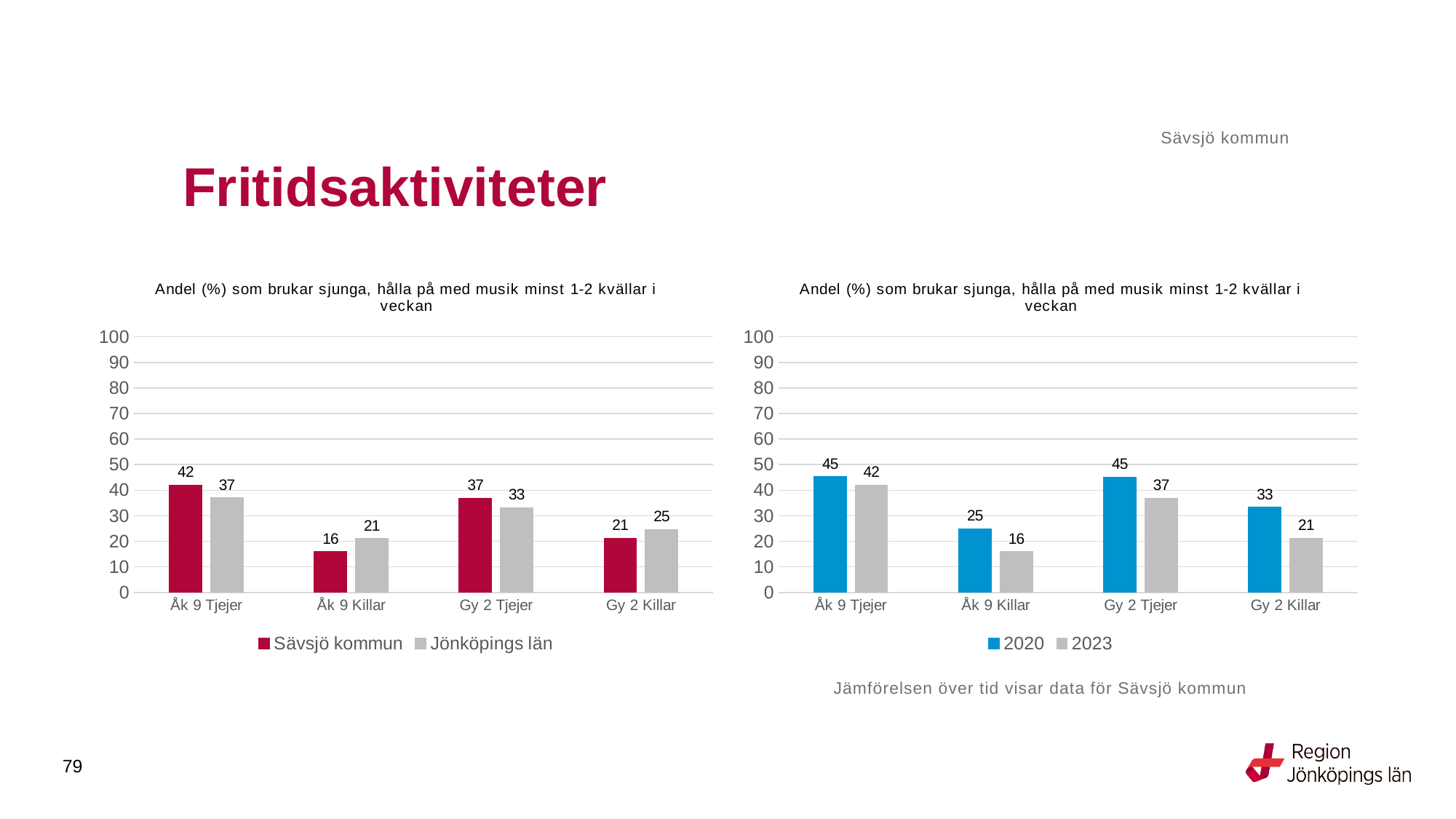
In the right chart, what is the value for 2020 for Gy 2 Killar? 33 What kind of chart is the right chart? Bar chart In the left chart, which category has the lowest value for Sävsjö kommun? Åk 9 Killar In the right chart, which category has the lowest value for 2023? Åk 9 Killar In the left chart, which is larger for Gy 2 Tjejer: Sävsjö kommun or Jönköpings län? Sävsjö kommun In the right chart, what is the value for 2023 for Åk 9 Killar? 16 In the left chart, what is the difference between Sävsjö kommun and Jönköpings län for Åk 9 Killar? 5 In the left chart, what is the value for Sävsjö kommun for Åk 9 Tjejer? 42 In the right chart, what is the difference between 2020 and 2023 for Åk 9 Killar? 9 In the left chart, what is the value for Jönköpings län for Gy 2 Killar? 25 How many series does the legend of the left chart list? 2 How many categories are shown on the x axis of the right chart? 4